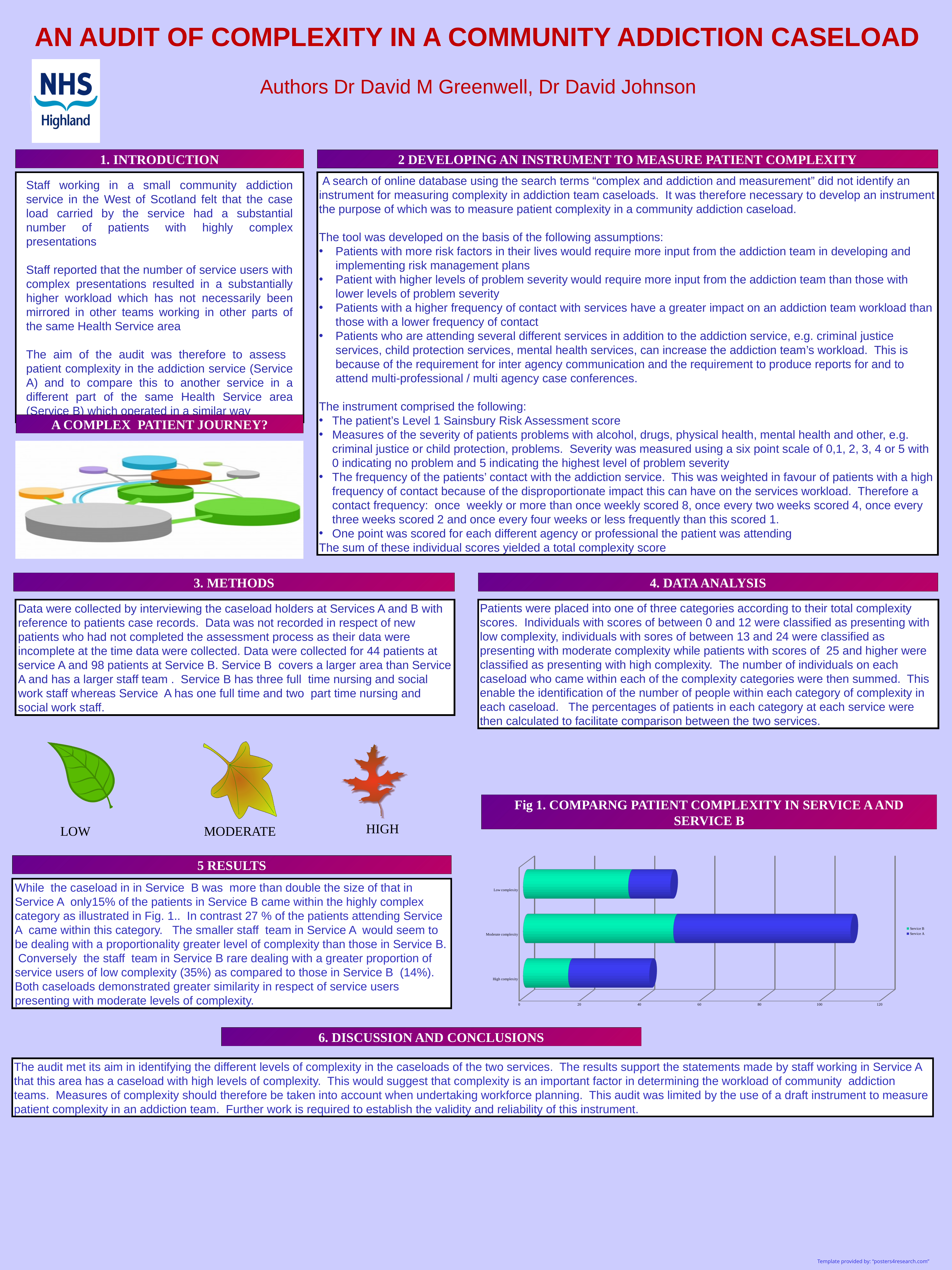
In Fig 1, which stacked bar is longer: Moderate complexity or High complexity? Moderate complexity What are the two series named in the legend of Fig 1? Service B and Service A Which category in Fig 1 has the longest stacked bar? Moderate complexity In Fig 1, is the total stacked bar for Moderate complexity greater or less than 100? greater What kind of chart is Fig 1? bar chart What is the highest tick value shown on the x axis of Fig 1? 120 In Fig 1, is the total stacked bar for Low complexity greater or less than 60? less In Fig 1, is the total stacked bar for High complexity greater or less than 60? less How many complexity categories are shown on the y axis of Fig 1? 3 How many series does the legend of Fig 1 list? 2